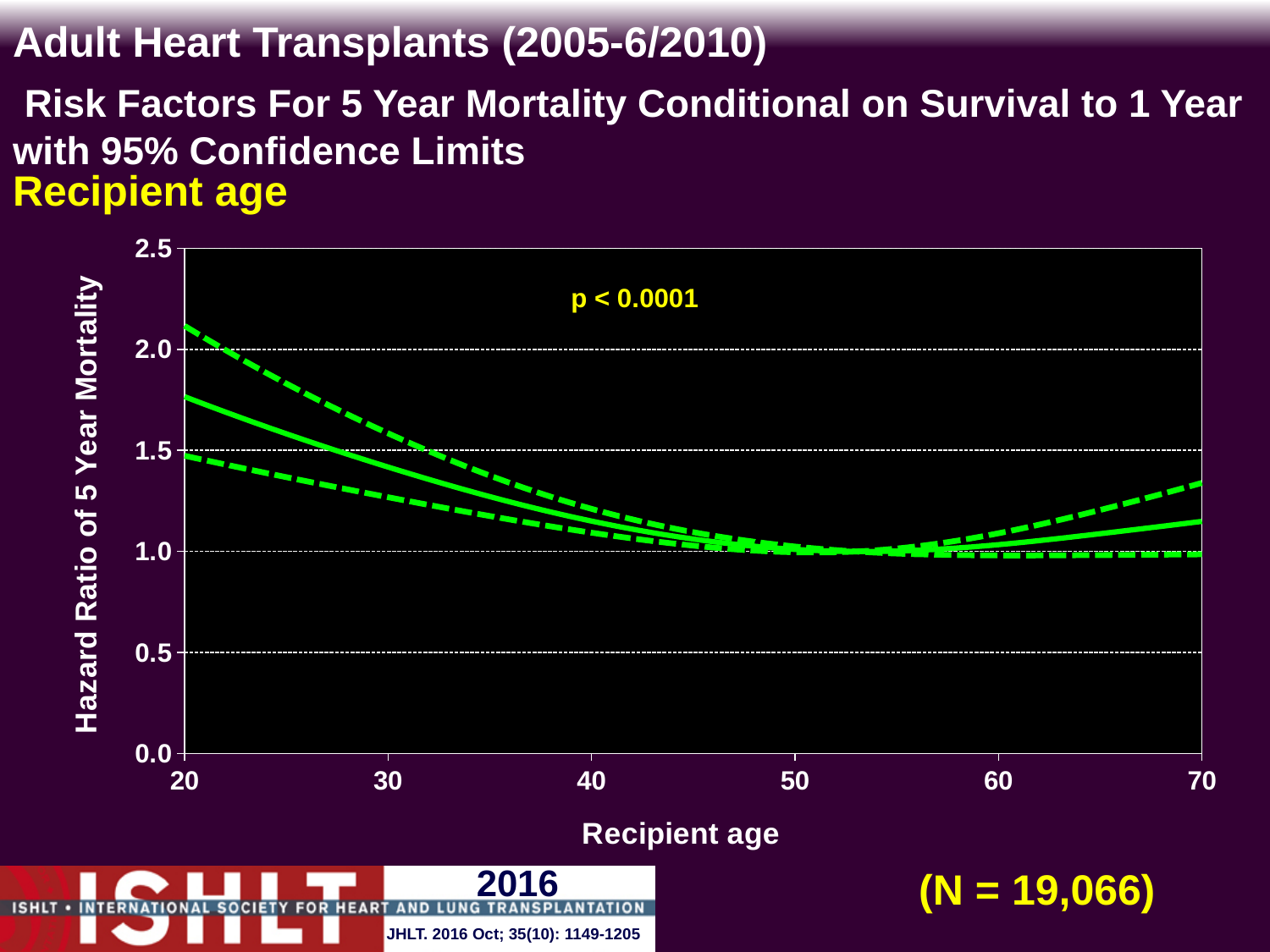
What is the label of the y axis of the chart? Hazard Ratio of 5 Year Mortality Is the hazard ratio on the upper dashed confidence limit at recipient age 20 greater or less than 2.0? greater How many lines are plotted on the chart? 3 What p-value is printed on the chart? p < 0.0001 Is the hazard ratio on the solid line at recipient age 40 greater or less than 1.5? less Which recipient age has the higher hazard ratio on the solid line, 20 or 60? 20 What variable is plotted on the x axis of the chart? Recipient age Does the hazard ratio on the solid line rise or fall as recipient age increases from 20 to 50? fall Is the hazard ratio on the solid line at recipient age 20 greater or less than 1.5? greater What kind of chart is shown on the slide? line chart